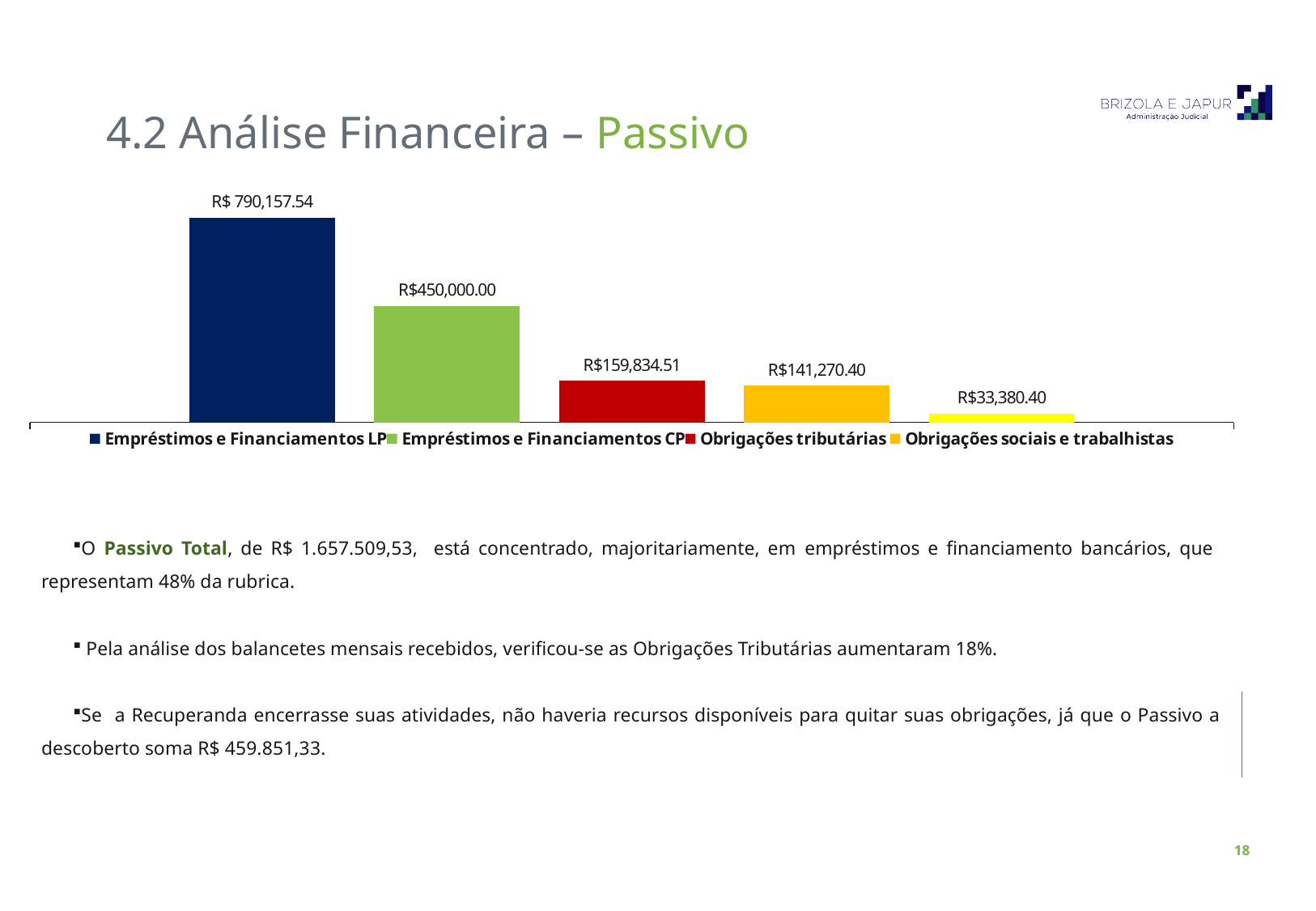
What colour is the Obrigações tributárias bar? Red What is the value of the Empréstimos e Financiamentos CP bar? R$450,000.00 What type of chart is shown on the slide? Bar chart How many bars are plotted in the chart? 5 What is the value shown for Obrigações tributárias? R$159,834.51 What is the difference between the Empréstimos e Financiamentos LP and Empréstimos e Financiamentos CP values? R$340,157.54 Which is larger, Obrigações tributárias or Obrigações sociais e trabalhistas? Obrigações tributárias What is the value of the Empréstimos e Financiamentos LP bar? R$ 790,157.54 What value is labelled on the rightmost (yellow) bar of the chart? R$33,380.40 Which category has the highest value in the chart? Empréstimos e Financiamentos LP What is the value shown for Obrigações sociais e trabalhistas? R$141,270.40 What is the difference between Obrigações tributárias and Obrigações sociais e trabalhistas? R$18,564.11